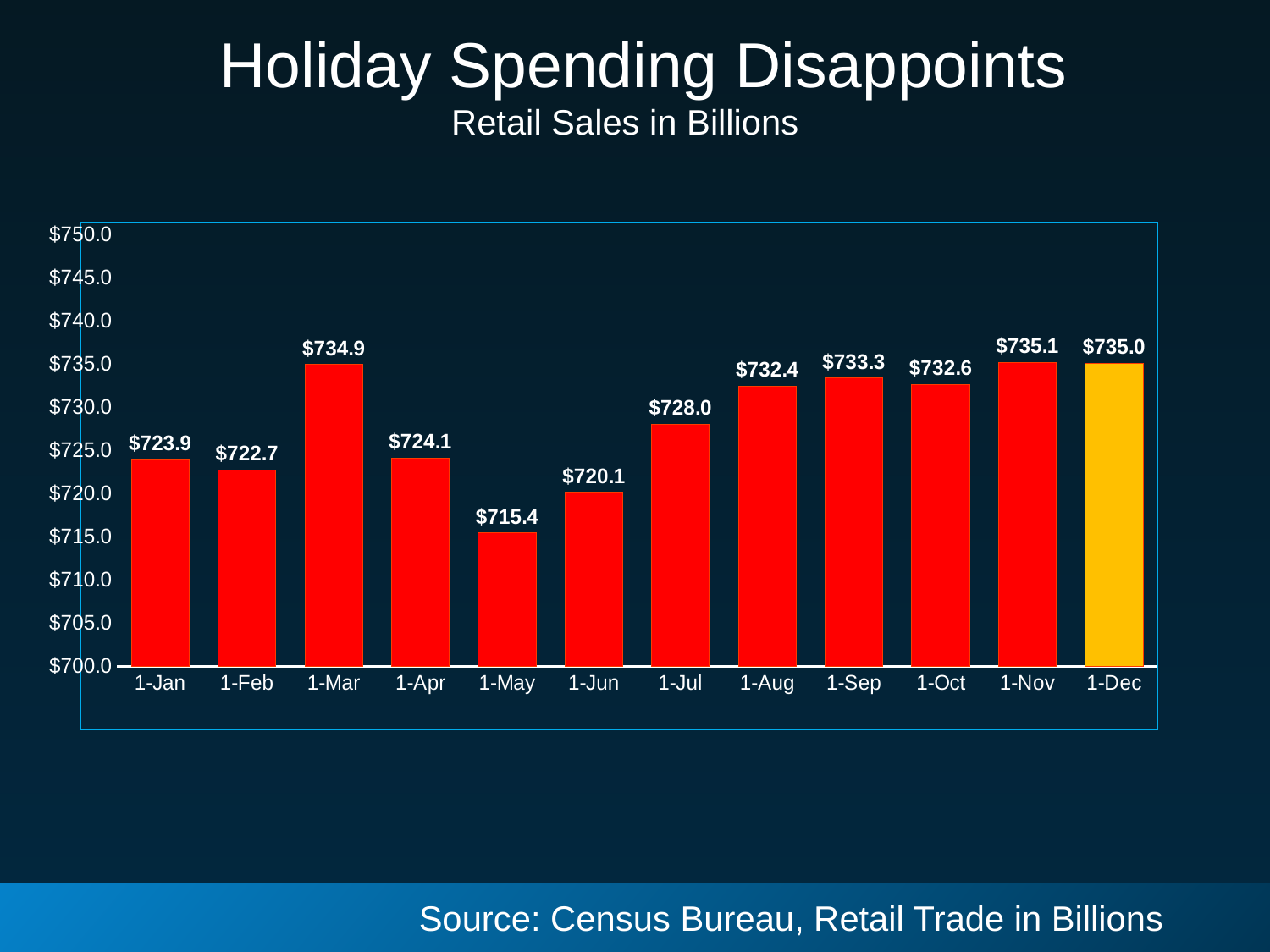
Which is larger, the value for 1-Jan or the value for 1-Feb? 1-Jan What is the retail sales value for 1-Dec? $735.0 Which month has the highest retail sales value? 1-Nov What is the retail sales value for 1-Mar? $734.9 What is the retail sales value for 1-Jul? $728.0 What kind of chart is shown on the slide? bar chart Which month has the lowest retail sales value? 1-May Is the value for 1-Jun greater or less than $725.0? less What is the difference between the values for 1-Mar and 1-May? $19.5 How many months are shown on the x axis? 12 What is the difference between the values for 1-Nov and 1-Dec? $0.1 Which bar is coloured differently from the others? 1-Dec